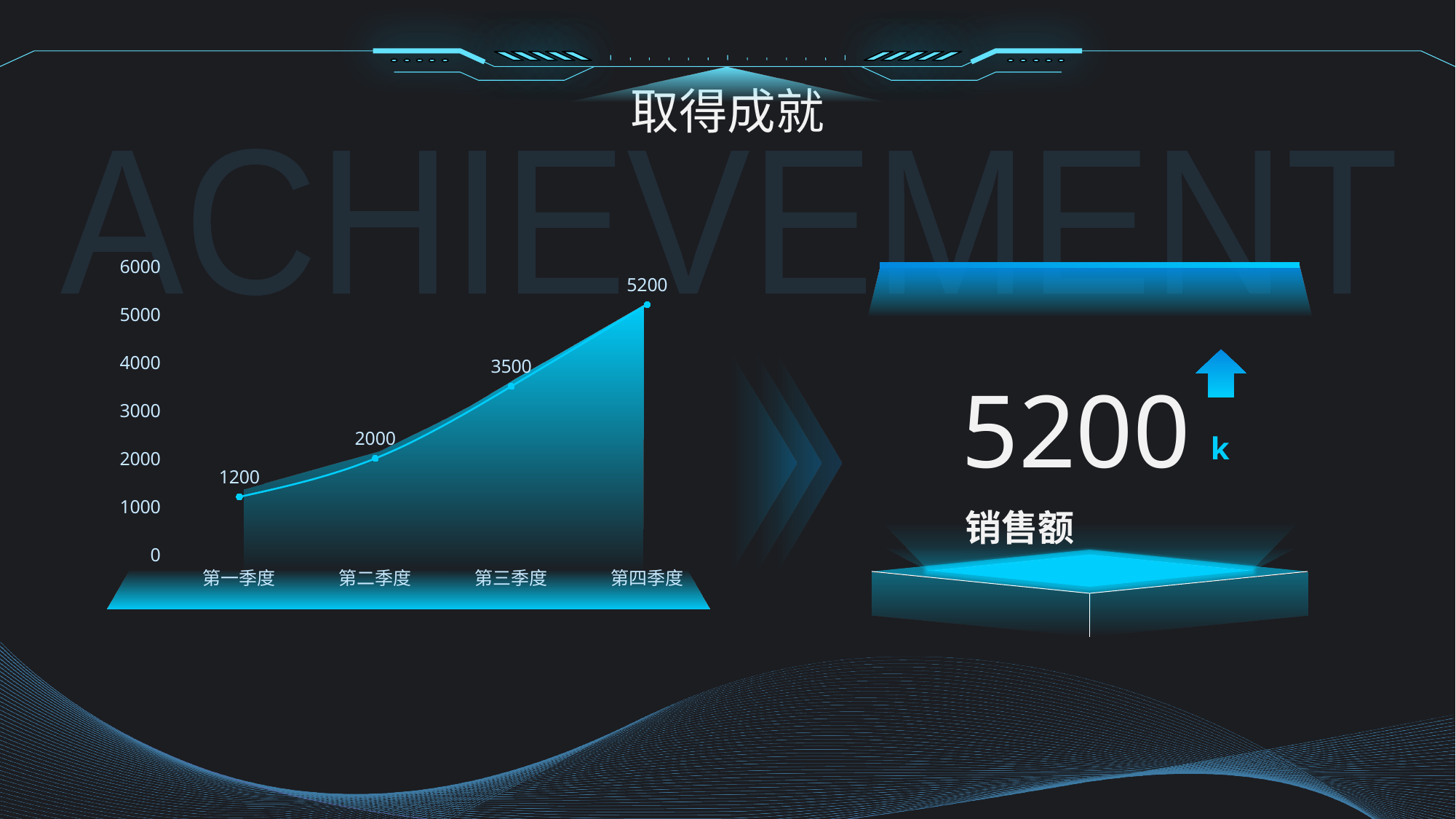
What is the value for 第二季度? 2000 Do the values rise or fall from 第一季度 to 第四季度? rise How many quarters are plotted on the chart? 4 What is the difference between the values for 第二季度 and 第一季度? 800 Which quarter has the lowest value? 第一季度 What is the difference between the values for 第四季度 and 第三季度? 1700 Which quarter has the highest value? 第四季度 What kind of chart is shown on the slide? area chart Which is larger, the value for 第三季度 or the value for 第二季度? 第三季度 What is the value for 第三季度? 3500 What is the value for 第四季度? 5200 What is the value for 第一季度? 1200